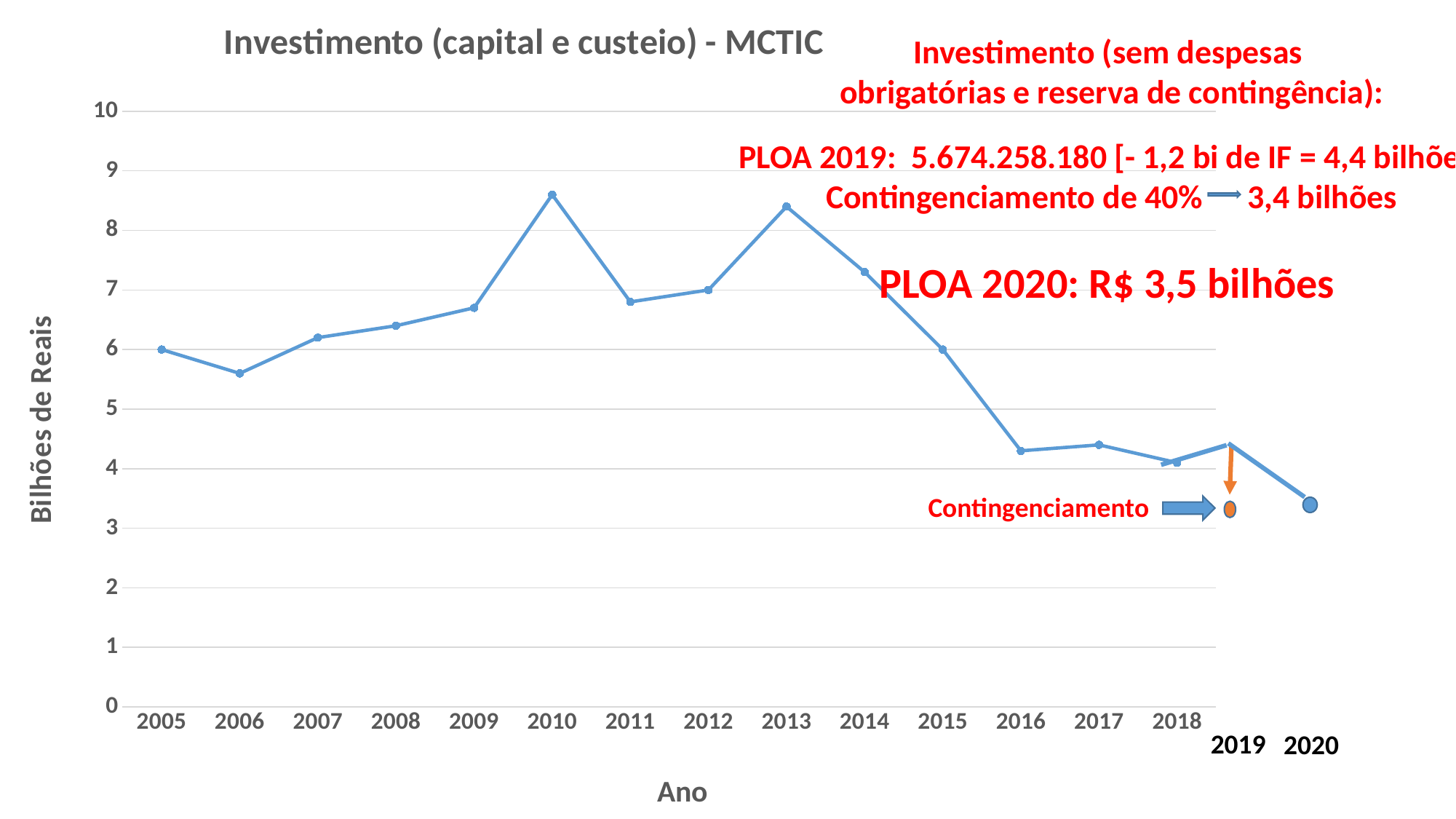
What is the title of the chart? Investimento (capital e custeio) - MCTIC Do the values rise or fall from 2013 to 2016? fall Is the value for 2006 greater or less than 6? less Which year has the larger value, 2005 or 2016? 2005 Do the values rise or fall from 2006 to 2010? rise Which year has the larger value, 2010 or 2015? 2010 Is the value for 2009 greater or less than 7? less Is the value for 2014 greater or less than 7? greater What is the label of the vertical axis? Bilhões de Reais What kind of chart is shown on the slide? line chart